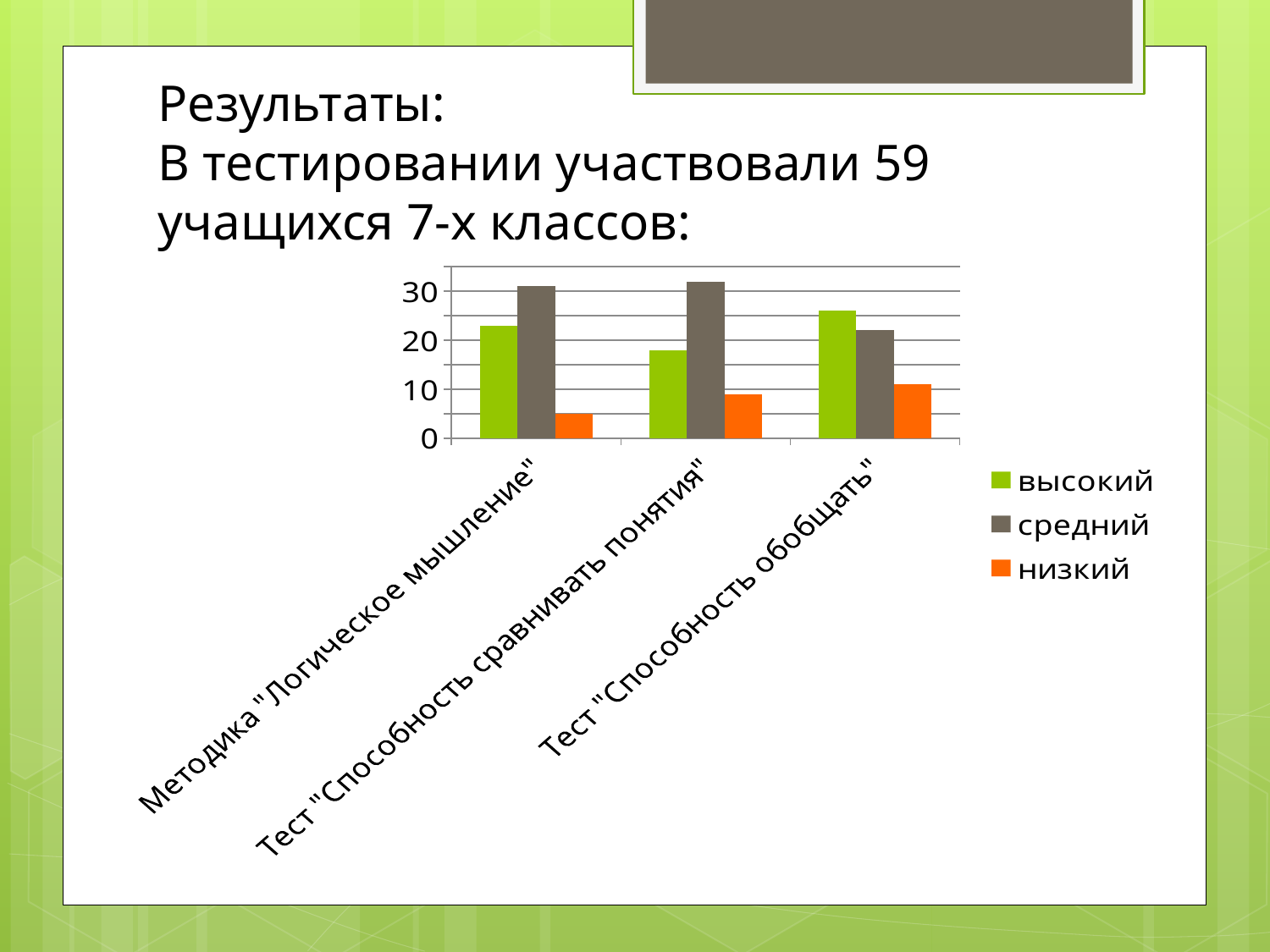
Is the value for высокий in Методика "Логическое мышление" greater or less than 20? greater How many series does the chart's legend list? 3 Which category has the lowest value for высокий? Тест "Способность сравнивать понятия" What kind of chart is shown on the slide? bar chart In Методика "Логическое мышление", which is larger: высокий or средний? средний Which category has the lowest value for низкий? Методика "Логическое мышление" Which series is shown in orange in the chart? низкий Is the value for низкий in Методика "Логическое мышление" greater or less than 10? less In Тест "Способность обобщать", which is larger: высокий or средний? высокий How many categories are shown on the x axis of the chart? 3 Is the value for высокий in Тест "Способность сравнивать понятия" greater or less than 20? less